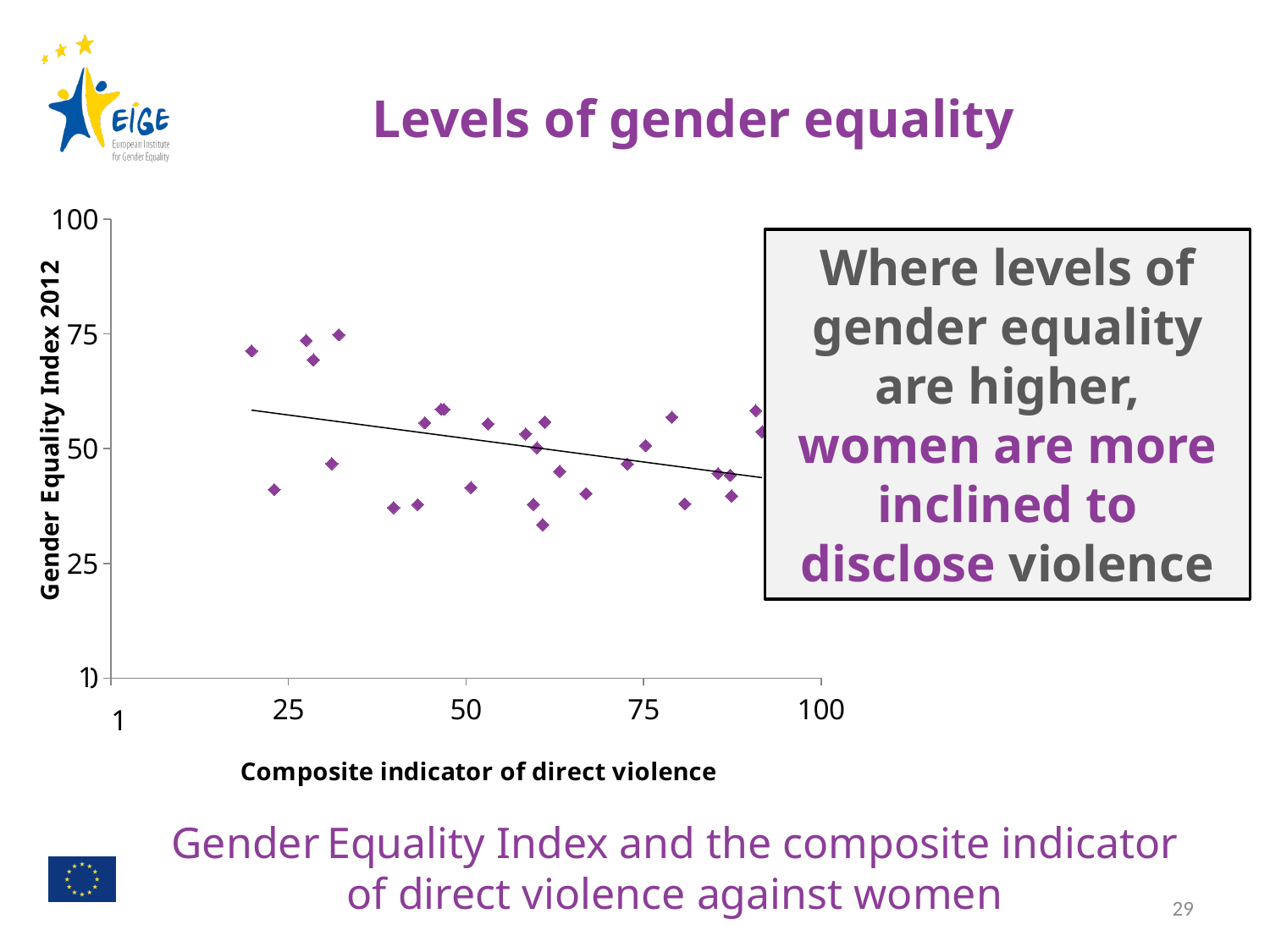
What kind of chart is shown on the slide? scatter plot What is the label of the vertical axis? Gender Equality Index 2012 What is the label of the horizontal axis? Composite indicator of direct violence Is the largest plotted value of the composite indicator of direct violence greater or less than 75? greater Is the highest plotted Gender Equality Index 2012 value greater or less than 50? greater Is the lowest plotted Gender Equality Index 2012 value greater or less than 25? greater According to the trend line, does the Gender Equality Index 2012 rise or fall as the composite indicator of direct violence increases? fall Does the fitted line in the chart slope upward or downward from left to right? downward